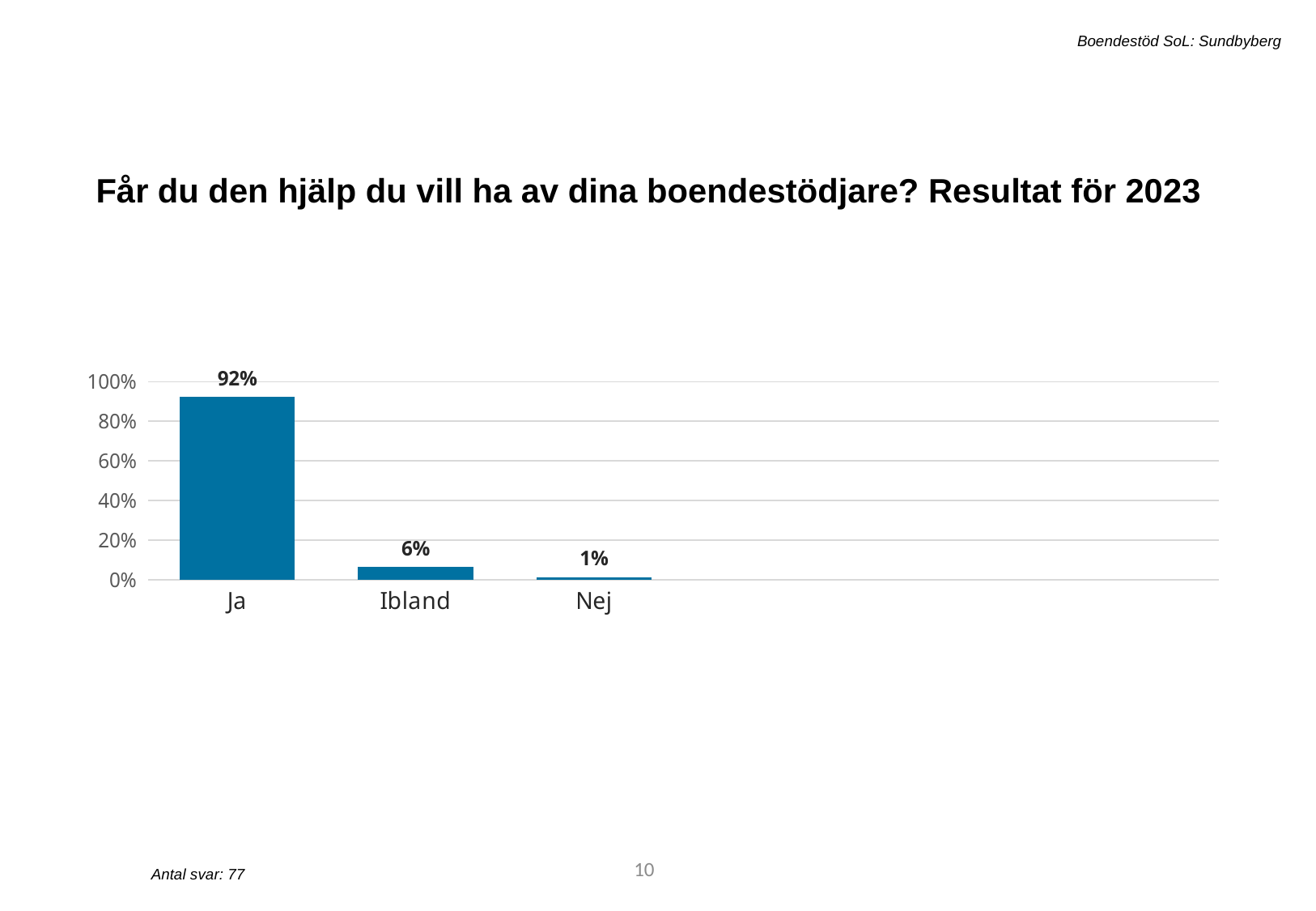
Which is larger, the value for Ibland or the value for Nej? Ibland What is the value for Ibland? 6% What is the value for Ja? 92% What is the difference between the values for Ibland and Nej? 5% What is the value for Nej? 1% What kind of chart is shown on the slide? bar chart What is the difference between the values for Ja and Ibland? 86% How many categories are shown on the x axis? 3 Is the value for Ja greater or less than 80%? greater Which category has the highest value? Ja What is the number of responses (Antal svar) stated on the slide? 77 Which category has the lowest value? Nej